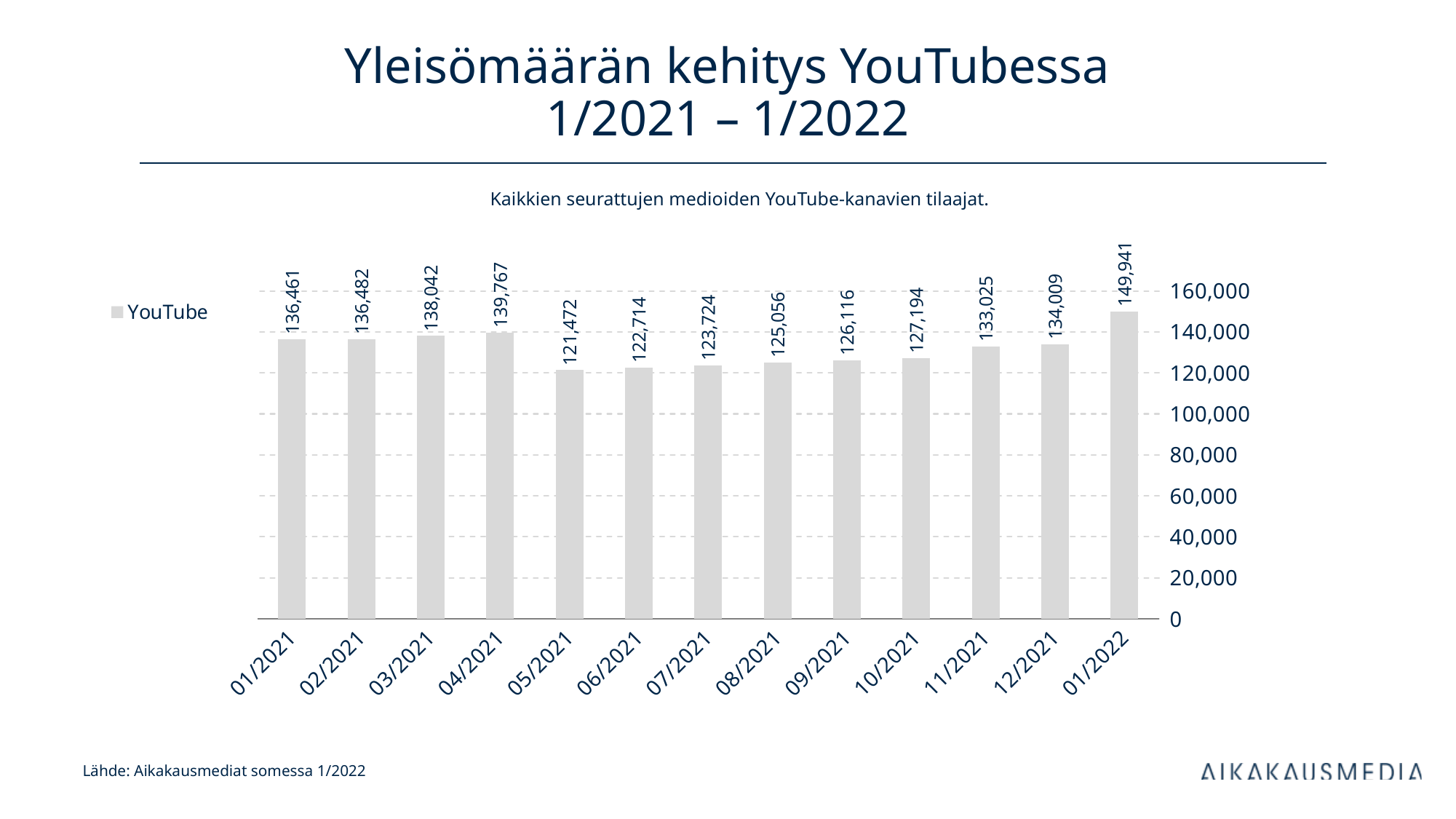
What is the difference between the values for 04/2021 and 05/2021? 18,295 How many series does the legend list? 1 What series name is shown in the legend? YouTube Which month has the highest value? 01/2022 Which month has the lowest value? 05/2021 What is the value for 10/2021? 127,194 What kind of chart is shown on the slide? bar chart What is the value for 01/2022? 149,941 What is the difference between the values for 01/2022 and 12/2021? 15,932 Which is larger, the value for 03/2021 or the value for 11/2021? 03/2021 What is the value for 05/2021? 121,472 How many months are shown on the x axis? 13